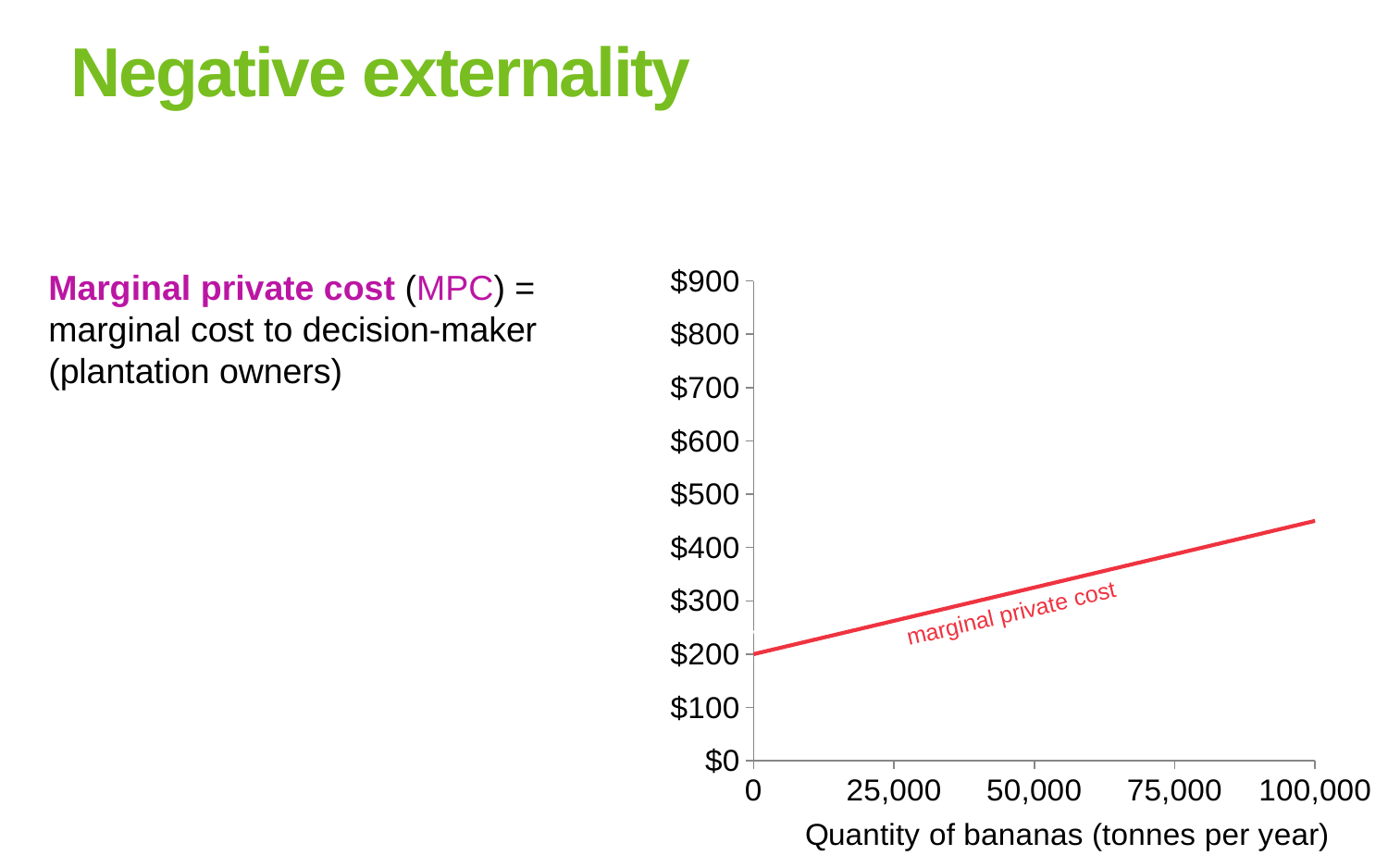
Is the marginal private cost at 100,000 tonnes per year greater or less than $400? greater Does the marginal private cost line rise or fall as the quantity of bananas increases? rise What kind of chart is shown on the slide? line chart What is the label of the x axis? Quantity of bananas (tonnes per year) Is the marginal private cost at 100,000 tonnes per year greater or less than $500? less What is the highest value shown on the y axis? $900 Is the marginal private cost at 25,000 tonnes per year greater or less than $300? less How many lines are plotted on the chart? 1 What is the marginal private cost when the quantity of bananas is 0? $200 Which is larger, the marginal private cost at 25,000 tonnes or at 75,000 tonnes? 75,000 tonnes